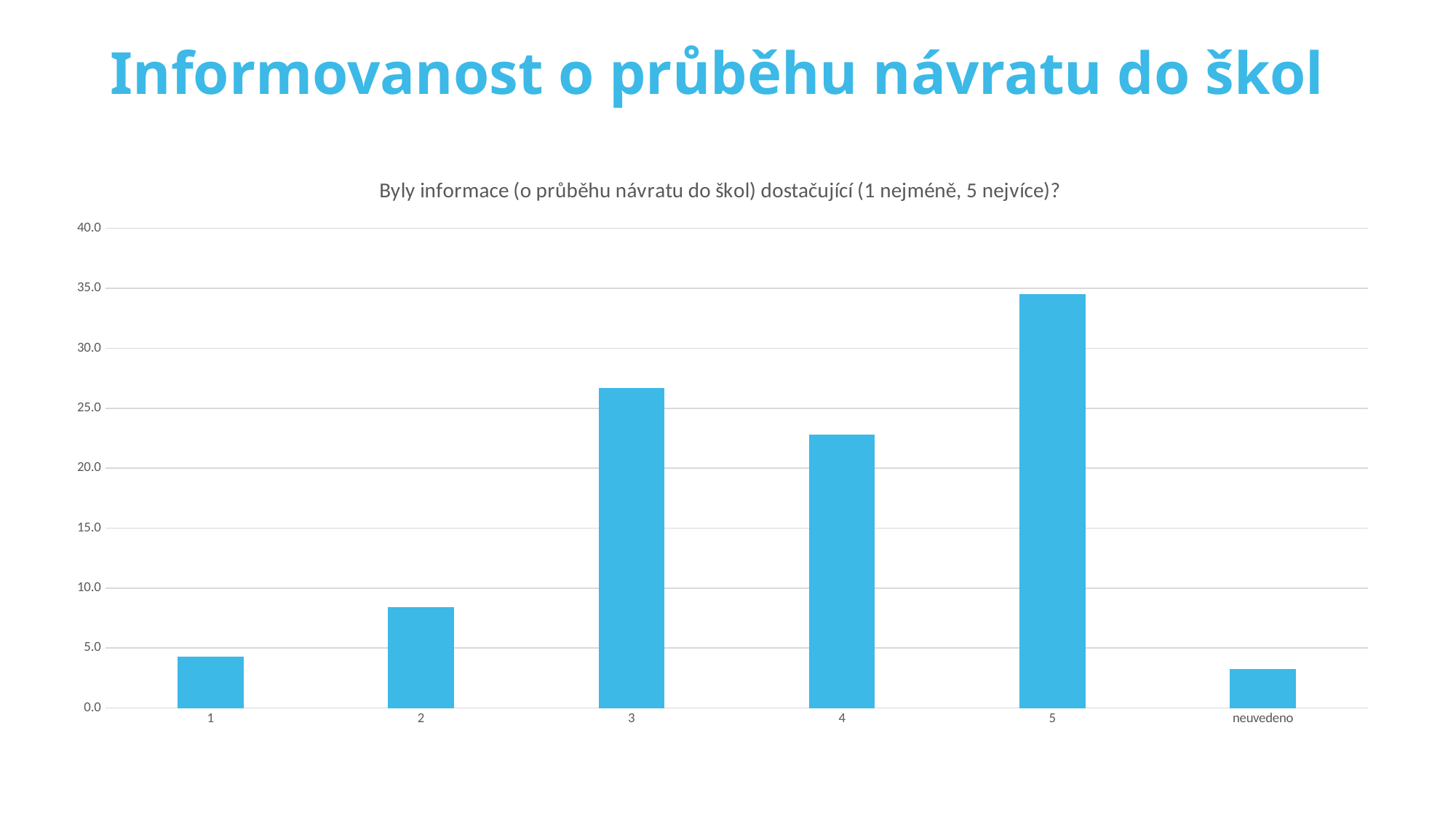
Is the value for category 4 greater or less than 25.0? less What is the title of the chart? Byly informace (o průběhu návratu do škol) dostačující (1 nejméně, 5 nejvíce)? Which has a larger value, category 3 or category 4? 3 How many categories are shown on the x axis of the chart? 6 Which category has the lowest bar in the chart? neuvedeno Is the value for category 4 greater or less than 20.0? greater Which category has the highest bar in the chart? 5 What kind of chart is shown on the slide? bar chart Is the value for category 2 greater or less than 10.0? less Which has a larger value, category 1 or category 2? 2 What is the highest value shown on the y axis of the chart? 40.0